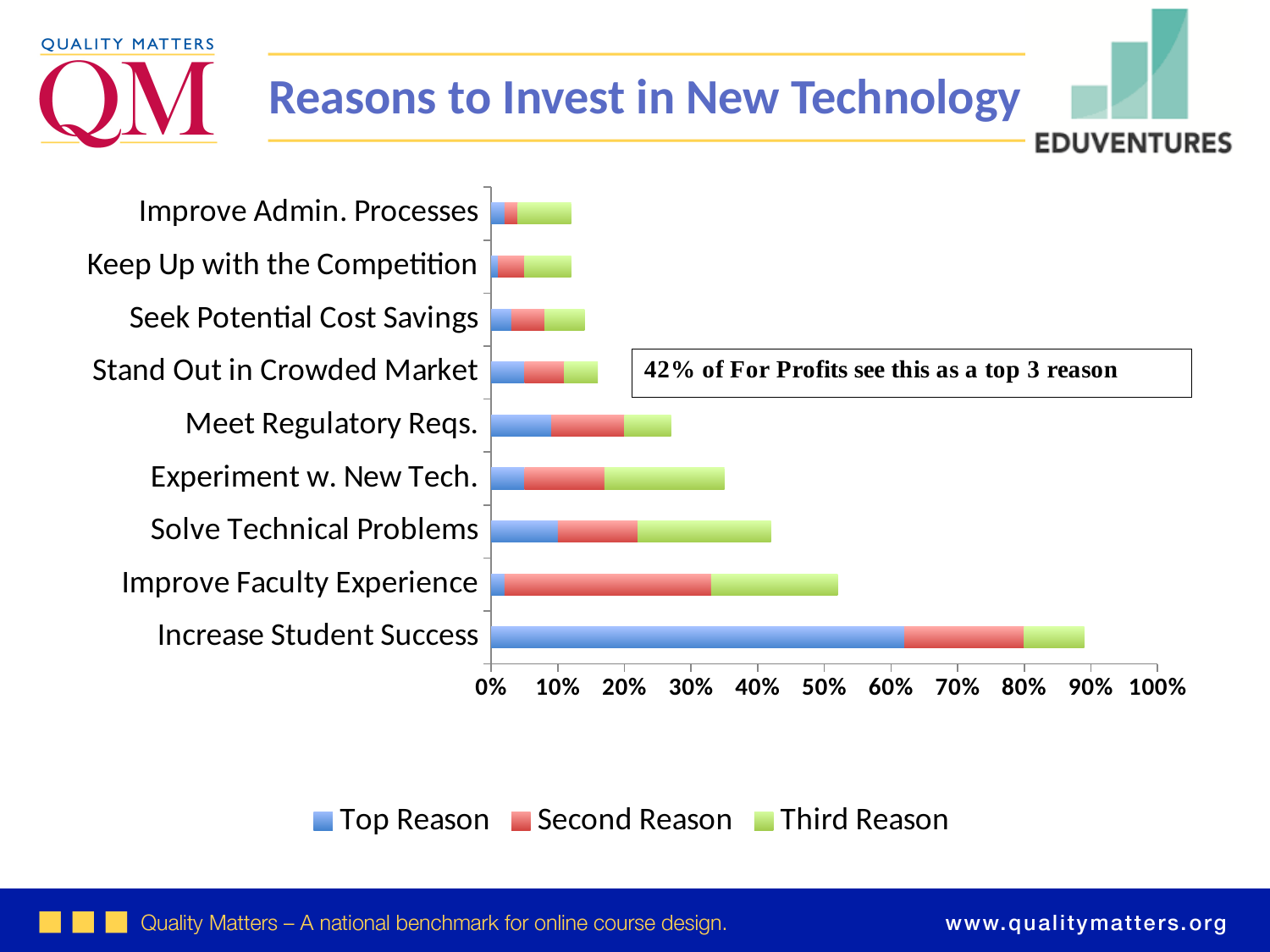
What kind of chart is shown on the slide? Stacked bar chart Is the total bar for Solve Technical Problems greater or less than 50%? less How many series does the legend list? 3 What is the title of the chart? Reasons to Invest in New Technology Is the total bar for Increase Student Success greater or less than 80%? greater Is the Top Reason segment for Increase Student Success greater or less than 50%? greater How many categories (reasons) are plotted on the chart? 9 Which has the longer total bar, Improve Faculty Experience or Experiment w. New Tech.? Improve Faculty Experience Which colour represents the Top Reason series in the legend? Blue Which reason has the longest total bar? Increase Student Success